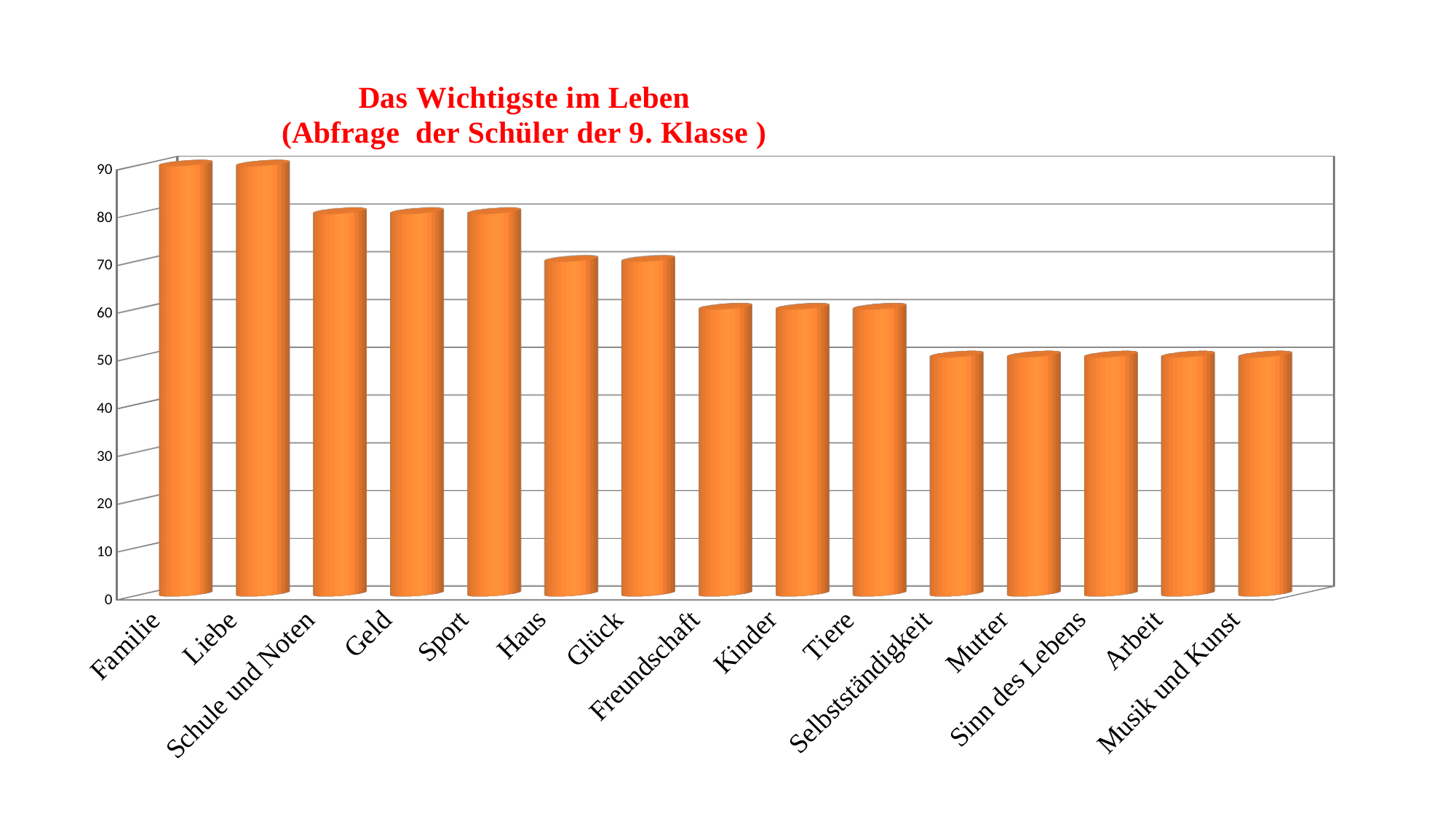
Which is larger, the value for Liebe or the value for Mutter? Liebe Which is larger, the value for Geld or the value for Kinder? Geld What is the value for Freundschaft? 60 How many categories are plotted in the chart? 15 Do the values rise or fall from left to right along the x axis? fall What is the difference between the value for Familie and the value for Musik und Kunst? 40 Is the value for Arbeit greater or less than 60? less What is the value for Haus? 70 What is the value for Familie? 90 Is the value for Glück greater or less than 60? greater What kind of chart is shown on the slide? bar chart What is the value for Musik und Kunst? 50